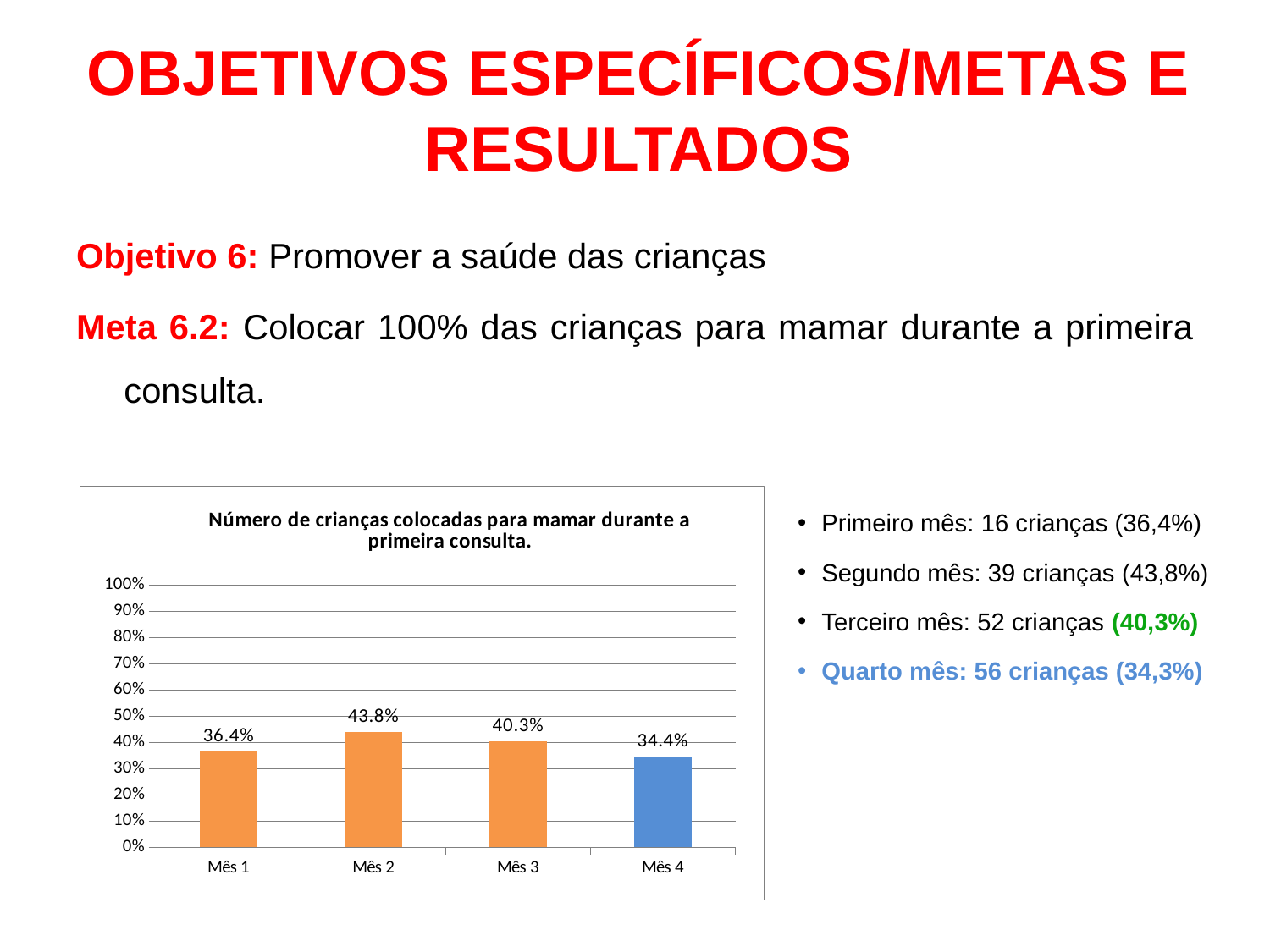
Which is larger, the value for Mês 1 or the value for Mês 3? Mês 3 What is the title of the chart? Número de crianças colocadas para mamar durante a primeira consulta. What is the value for Mês 2? 43.8% What is the value for Mês 4? 34.4% Which month has the lowest value? Mês 4 What is the value for Mês 3? 40.3% What is the value for Mês 1? 36.4% What is the difference between the values for Mês 2 and Mês 4? 9.4% Which month has the highest value? Mês 2 What kind of chart is shown? bar chart Is the value for Mês 2 greater or less than 50%? less How many months are shown on the x axis? 4